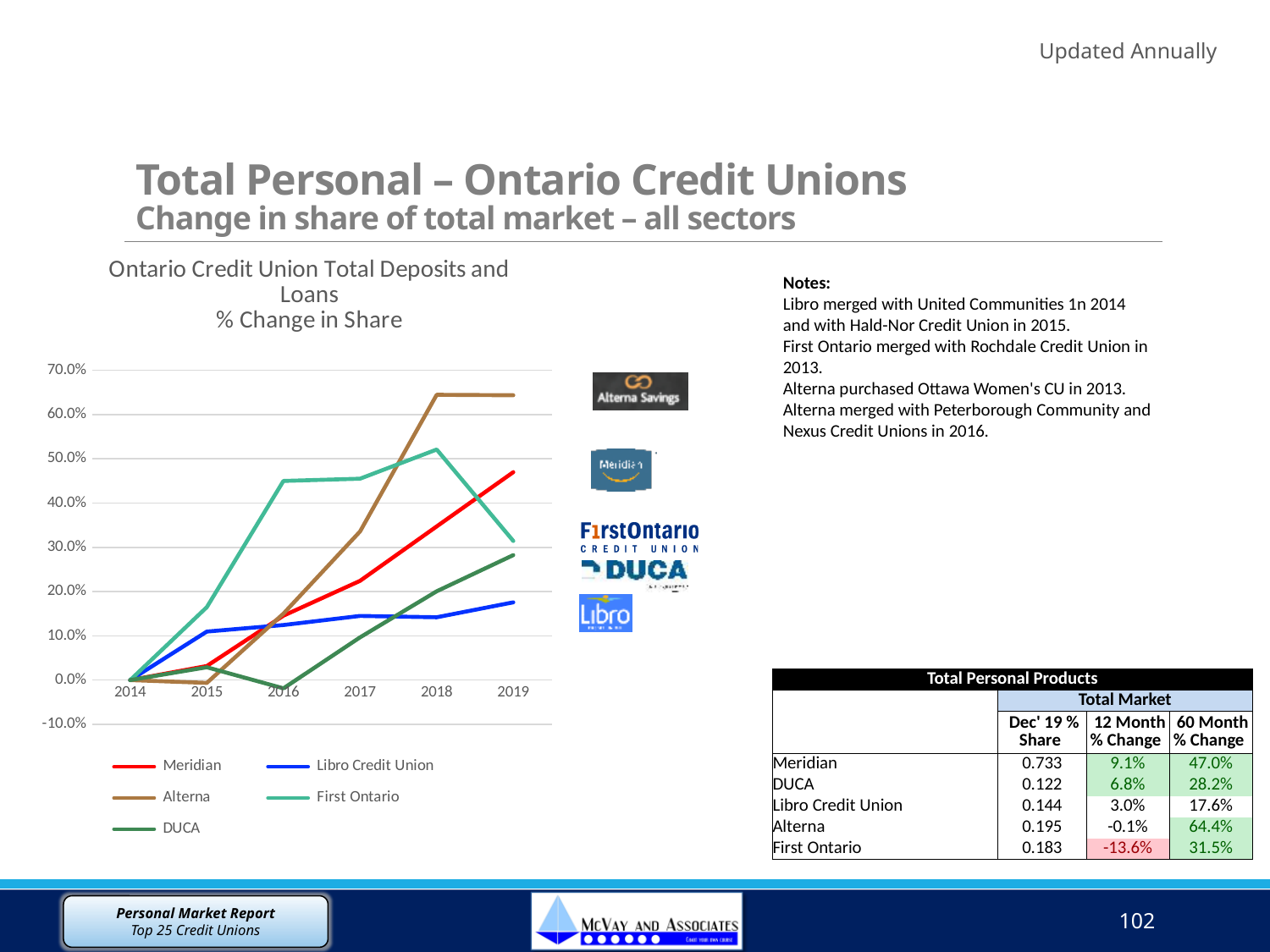
Is the value for Libro Credit Union in 2019 greater or less than 20.0%? less Is the value for First Ontario in 2016 greater or less than 40.0%? greater Which series has the highest value in 2019? Alterna What kind of chart is shown on the slide? line chart How many years are shown along the x axis of the chart? 6 Is the value for Alterna in 2019 greater or less than 60.0%? greater Which series has the highest value in 2016? First Ontario How many series does the chart legend list? 5 In 2018, which is larger: the value for Alterna or the value for First Ontario? Alterna Does the Meridian line rise or fall from 2014 to 2019? rise What colour is the Meridian line in the chart? red Which series has the lowest value in 2019? Libro Credit Union